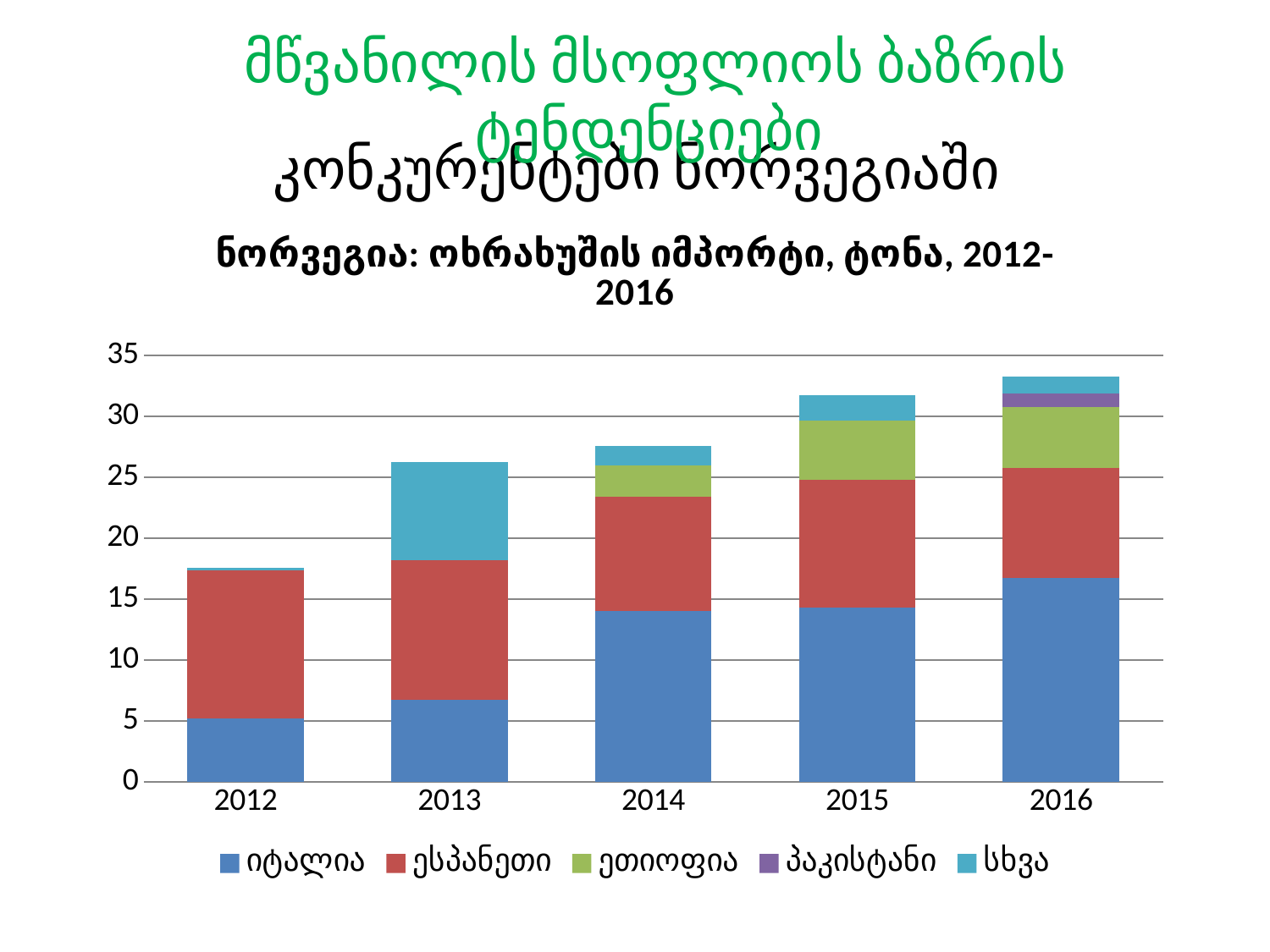
Is the value for იტალია in 2016 greater or less than 15? greater How many years (categories) are shown on the x axis? 5 Which year has the lowest total stacked bar? 2012 Is the value for იტალია in 2012 greater or less than 10? less Is the total for 2012 greater or less than 20? less Which series is listed first in the legend? იტალია What kind of chart is shown on the slide? stacked bar chart Do the total bar heights rise or fall from 2012 to 2016? rise Which is larger: the total for 2015 or the total for 2014? 2015 How many series does the legend list? 5 Which year has the highest total stacked bar? 2016